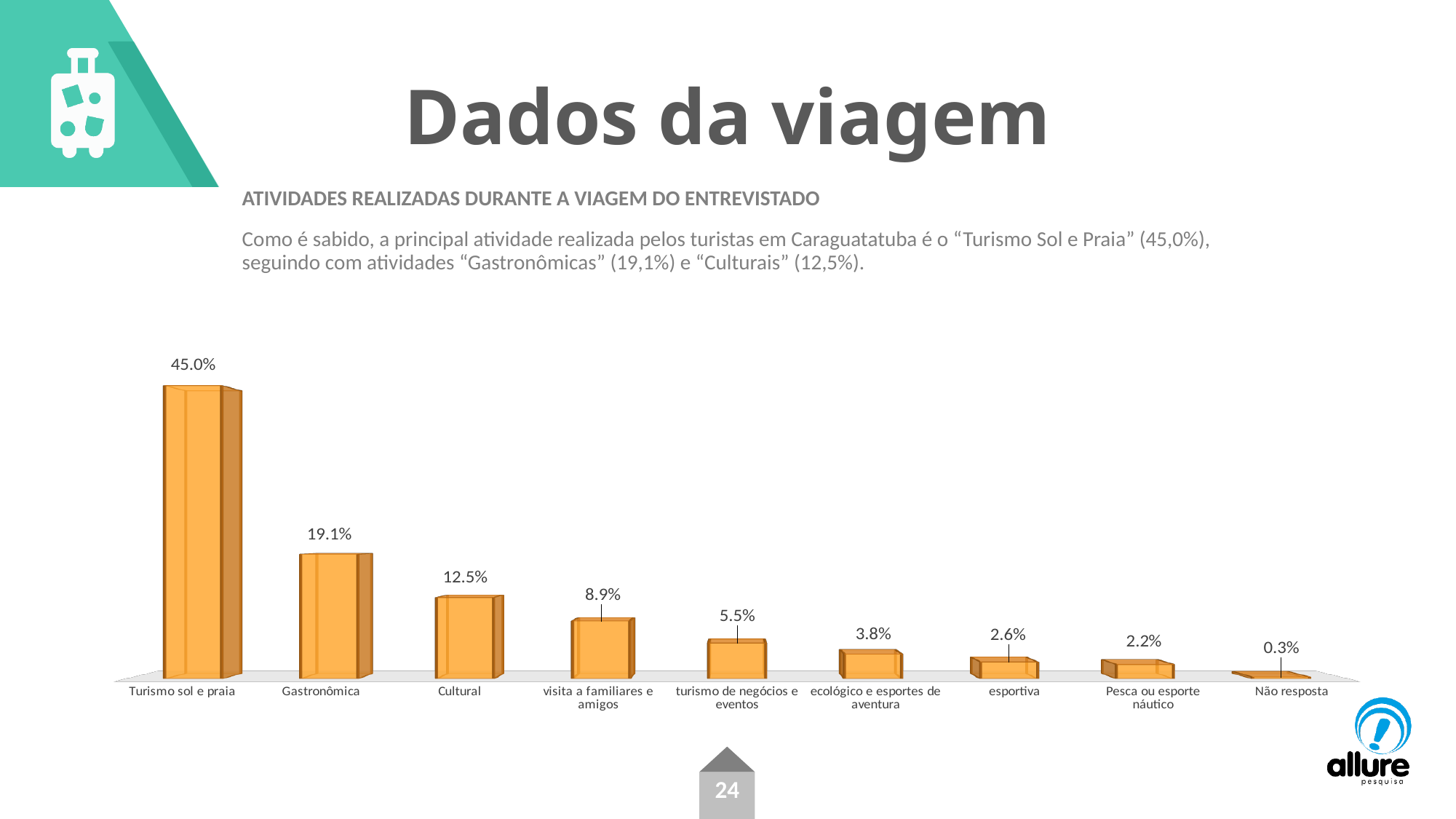
Which category has the highest value? Turismo sol e praia Do the values rise or fall from left to right along the x axis? fall What kind of chart is shown on the slide? bar chart What is the difference between the values for Turismo sol e praia and Gastronômica? 25.9% What is the difference between the values for Cultural and visita a familiares e amigos? 3.6% Which is larger, the value for turismo de negócios e eventos or the value for esportiva? turismo de negócios e eventos What is the value for ecológico e esportes de aventura? 3.8% What is the value for Turismo sol e praia? 45.0% How many categories are shown in the chart? 9 What is the value for Gastronômica? 19.1% Which category has the lowest value? Não resposta What is the value for Pesca ou esporte náutico? 2.2%